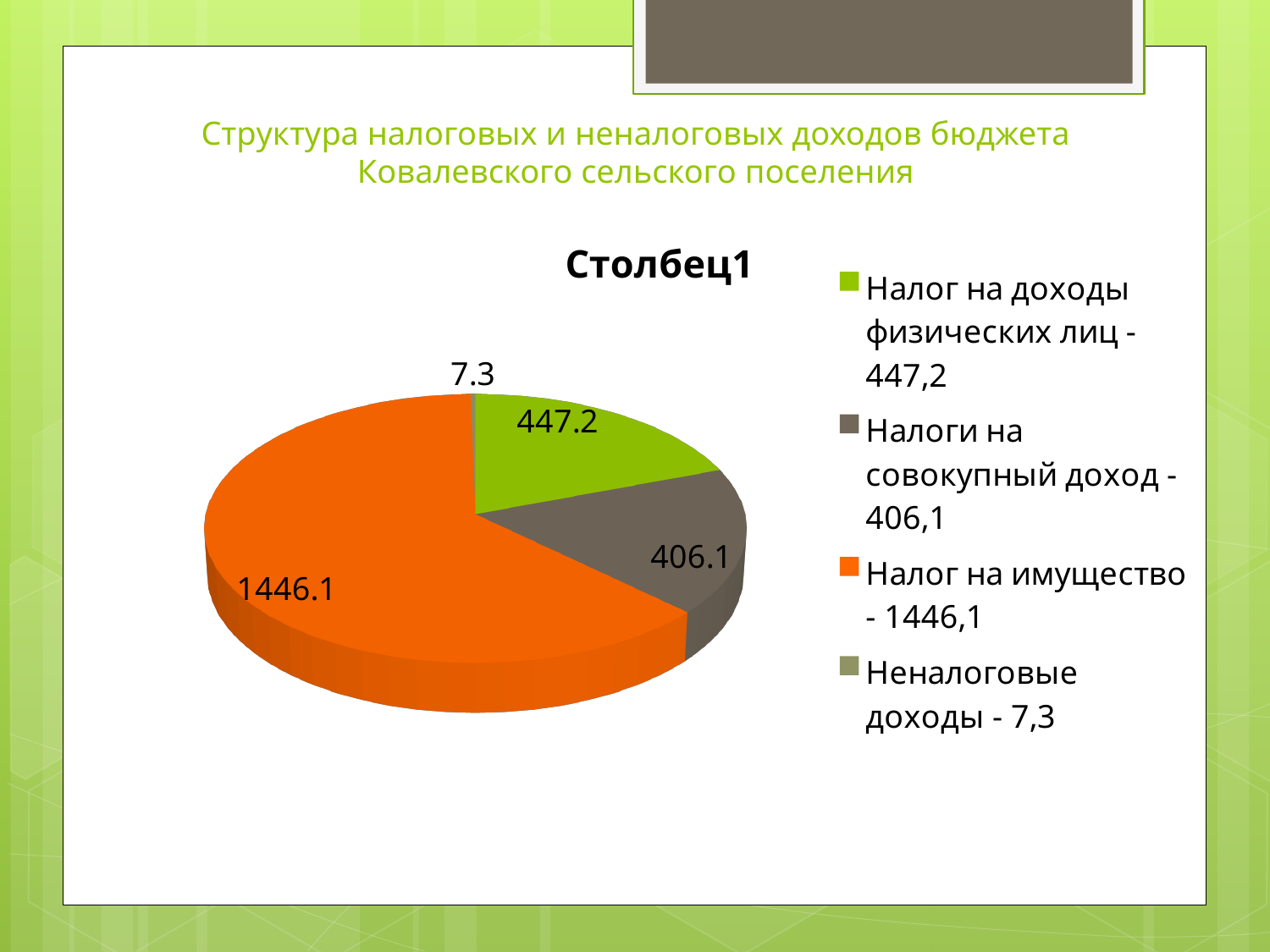
What is the title of the chart? Столбец1 Which category has the largest slice of the pie? Налог на имущество What colour is the slice for Налог на имущество? Orange Which category has the smallest slice of the pie? Неналоговые доходы What is the value for Налог на доходы физических лиц? 447.2 Which is larger: the value for Налог на имущество or the value for Налог на доходы физических лиц? Налог на имущество What is the difference between the values for Налог на доходы физических лиц and Налоги на совокупный доход? 41.1 What is the value for Налог на имущество? 1446.1 What is the value for Неналоговые доходы? 7.3 What is the value for Налоги на совокупный доход? 406.1 What kind of chart is shown on the slide? Pie chart How many slices does the pie chart have? 4